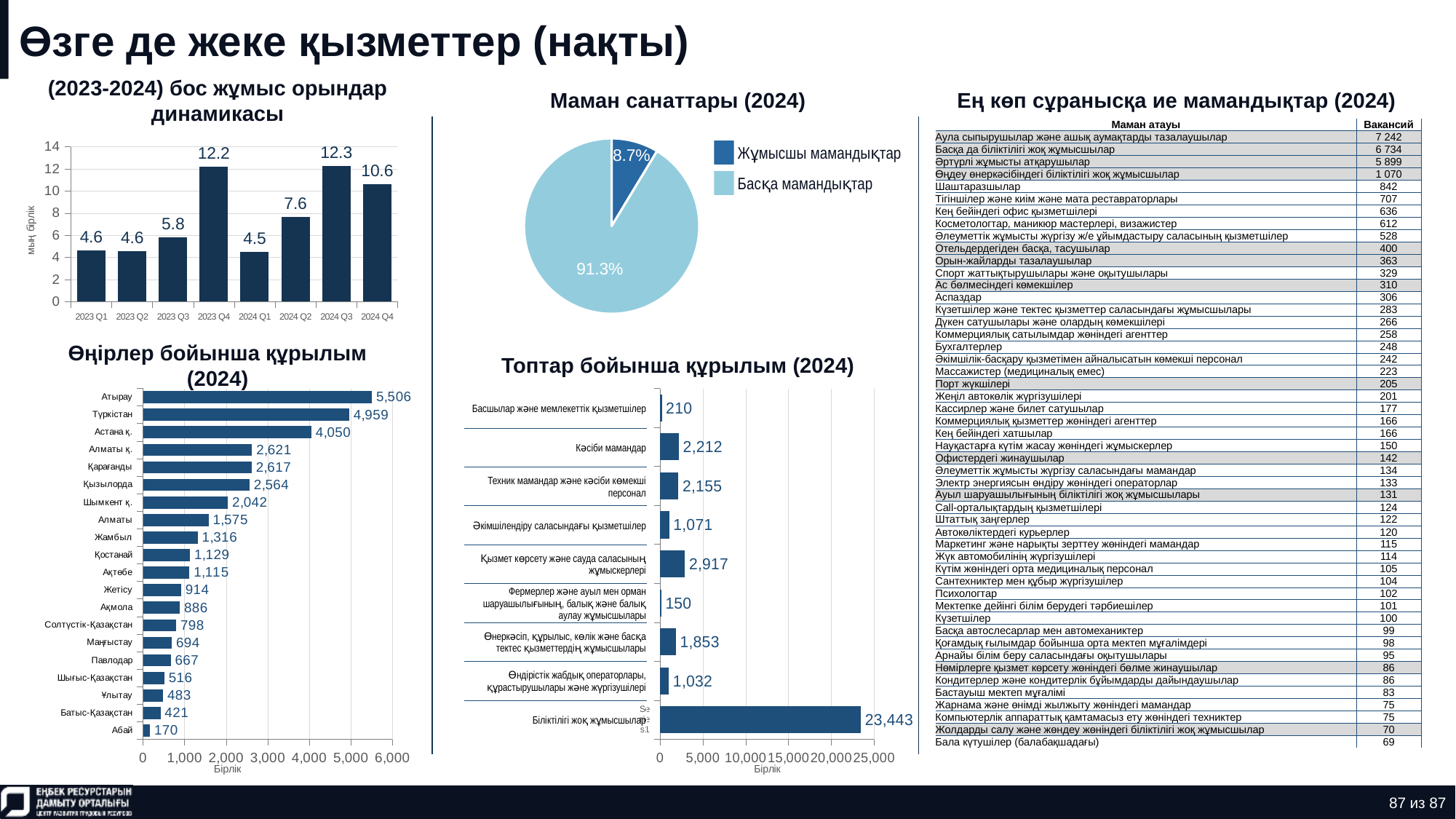
In the chart "(2023-2024) бос жұмыс орындар динамикасы", which quarter has the lowest value? 2024 Q1 In the chart "Топтар бойынша құрылым (2024)", what is the value for "Кәсіби мамандар"? 2,212 How many series does the legend of the pie chart "Маман санаттары (2024)" list? 2 In the chart "Өңірлер бойынша құрылым (2024)", what is the difference between Атырау and Түркістан? 547 What kind of chart is "Топтар бойынша құрылым (2024)"? Bar chart In the pie chart "Маман санаттары (2024)", what share does "Жұмысшы мамандықтар" have? 8.7% In the chart "(2023-2024) бос жұмыс орындар динамикасы", what is the difference between 2023 Q4 and 2023 Q3? 6.4 In the chart "Өңірлер бойынша құрылым (2024)", which region has the highest value? Атырау In the chart "Өңірлер бойынша құрылым (2024)", which is larger, Жамбыл or Қостанай? Жамбыл In the chart "(2023-2024) бос жұмыс орындар динамикасы", how many quarters are plotted? 8 In the chart "Өңірлер бойынша құрылым (2024)", what is the value for Шымкент қ.? 2,042 In the chart "(2023-2024) бос жұмыс орындар динамикасы", what is the value for 2024 Q3? 12.3